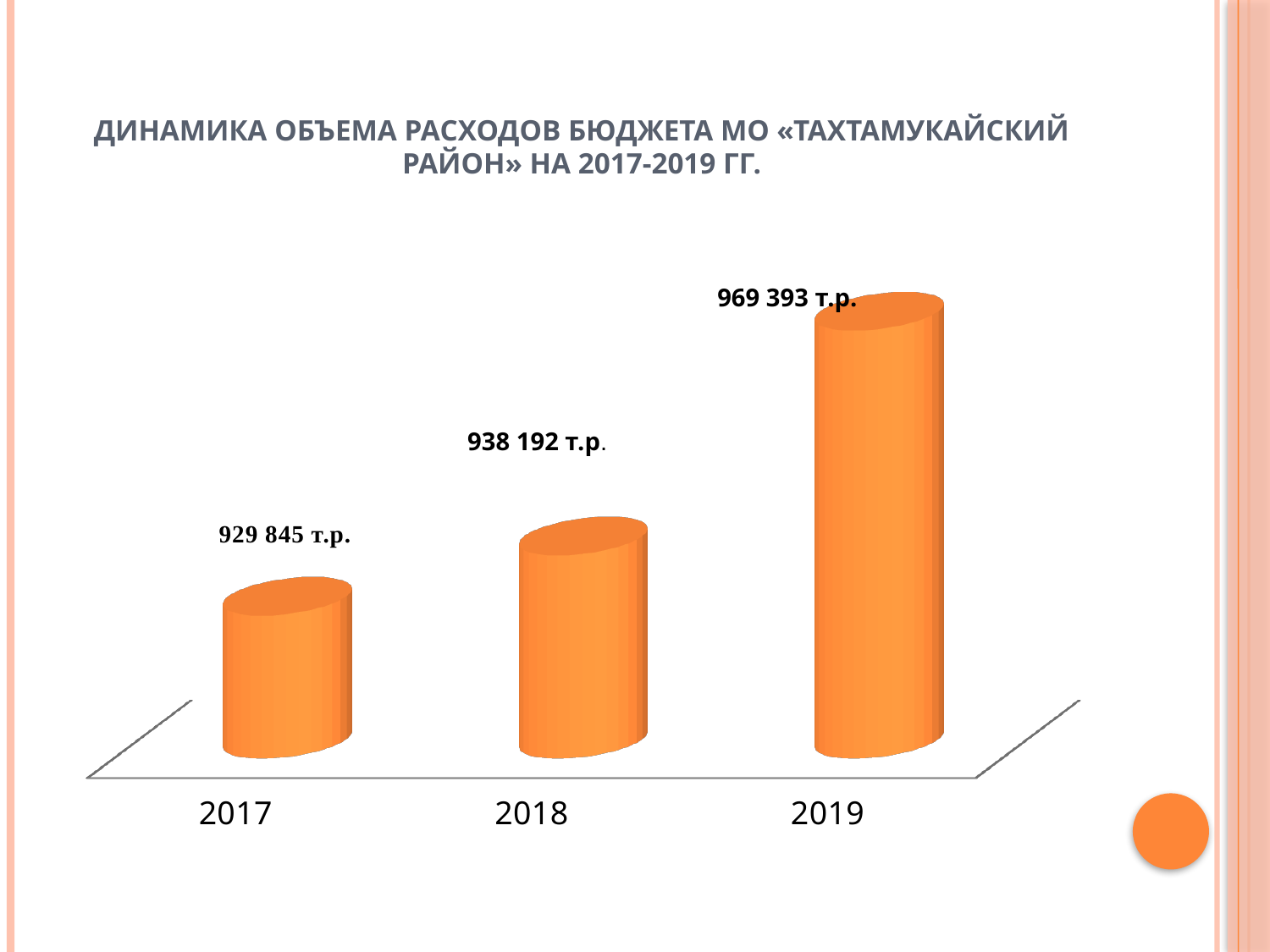
Which year has the highest budget expenditure value? 2019 What is the budget expenditure value shown for 2019? 969 393 т.р. Which is larger, the value for 2018 or the value for 2019? 2019 What is the budget expenditure value shown for 2017? 929 845 т.р. What is the difference between the 2018 and 2017 values? 8 347 т.р. By how much does the 2019 value exceed the 2018 value? 31 201 т.р. Do the values rise or fall from 2017 to 2019? Rise How many years are shown on the chart? 3 What kind of chart is shown on the slide? Bar chart What is the difference between the 2019 and 2017 values? 39 548 т.р. What is the budget expenditure value shown for 2018? 938 192 т.р. Which year has the lowest budget expenditure value? 2017